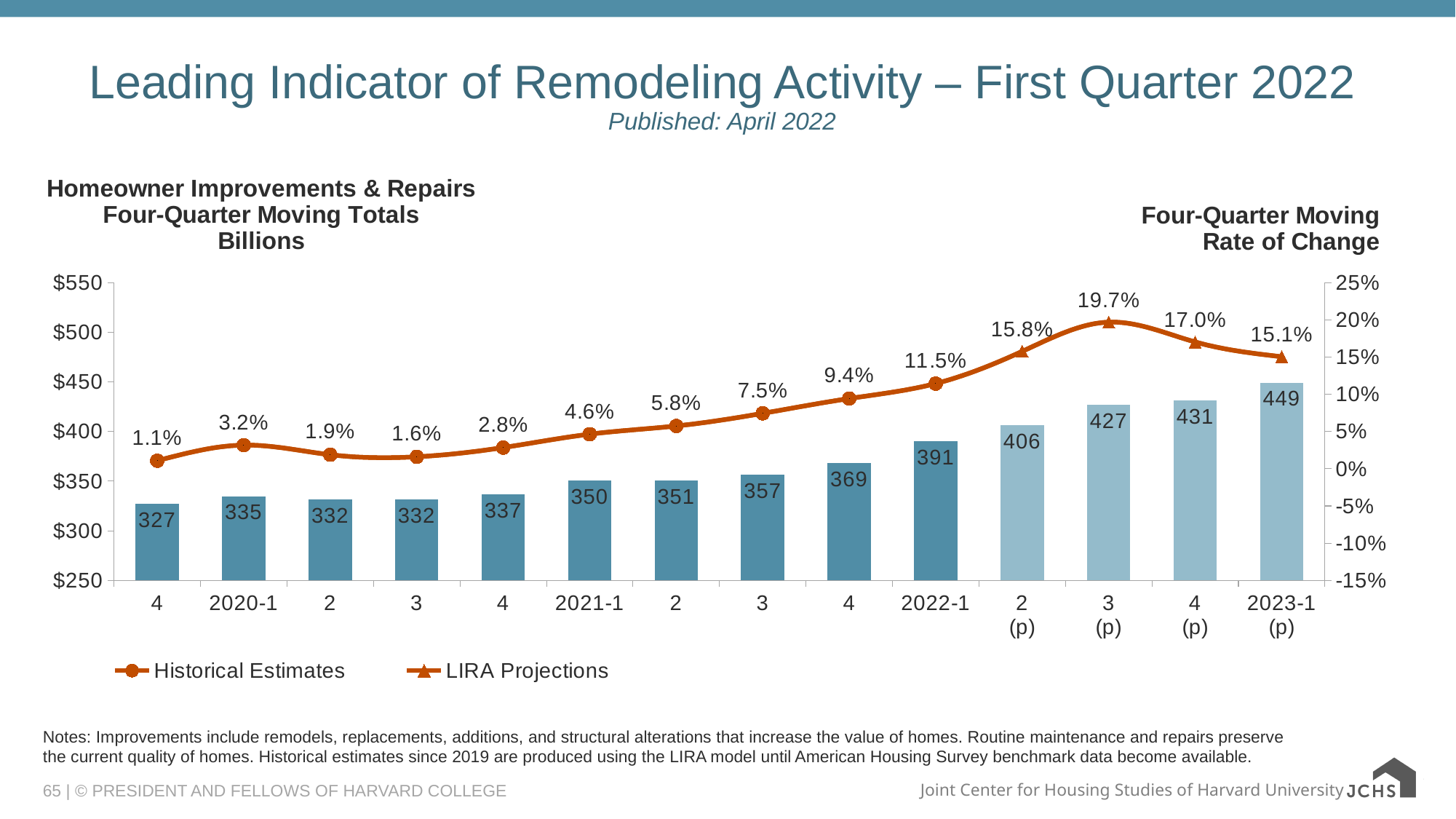
Do the four-quarter moving totals generally rise or fall from 2021-1 to 2023-1 (p)? rise Which period has the lowest four-quarter moving total bar? 4 (2019) What kinds of chart are combined on this slide? Bar chart and line chart What is the difference between the four-quarter moving totals for 2023-1 (p) and 2022-1? 58 Which period has the highest four-quarter moving rate of change? 3 (p) (2022) What is the four-quarter moving total (in billions) for 2021-1? 350 Is the four-quarter moving total for 3 (p) of 2022 greater or less than $400 billion? greater What is the four-quarter moving total (in billions) for 2022-1? 391 How many periods are shown on the x axis? 14 How many series does the legend list? 2 Which is larger, the rate of change for 2022-1 or for 2 (p) of 2022? 2 (p) of 2022 What is the four-quarter moving rate of change for 2023-1 (p)? 15.1%